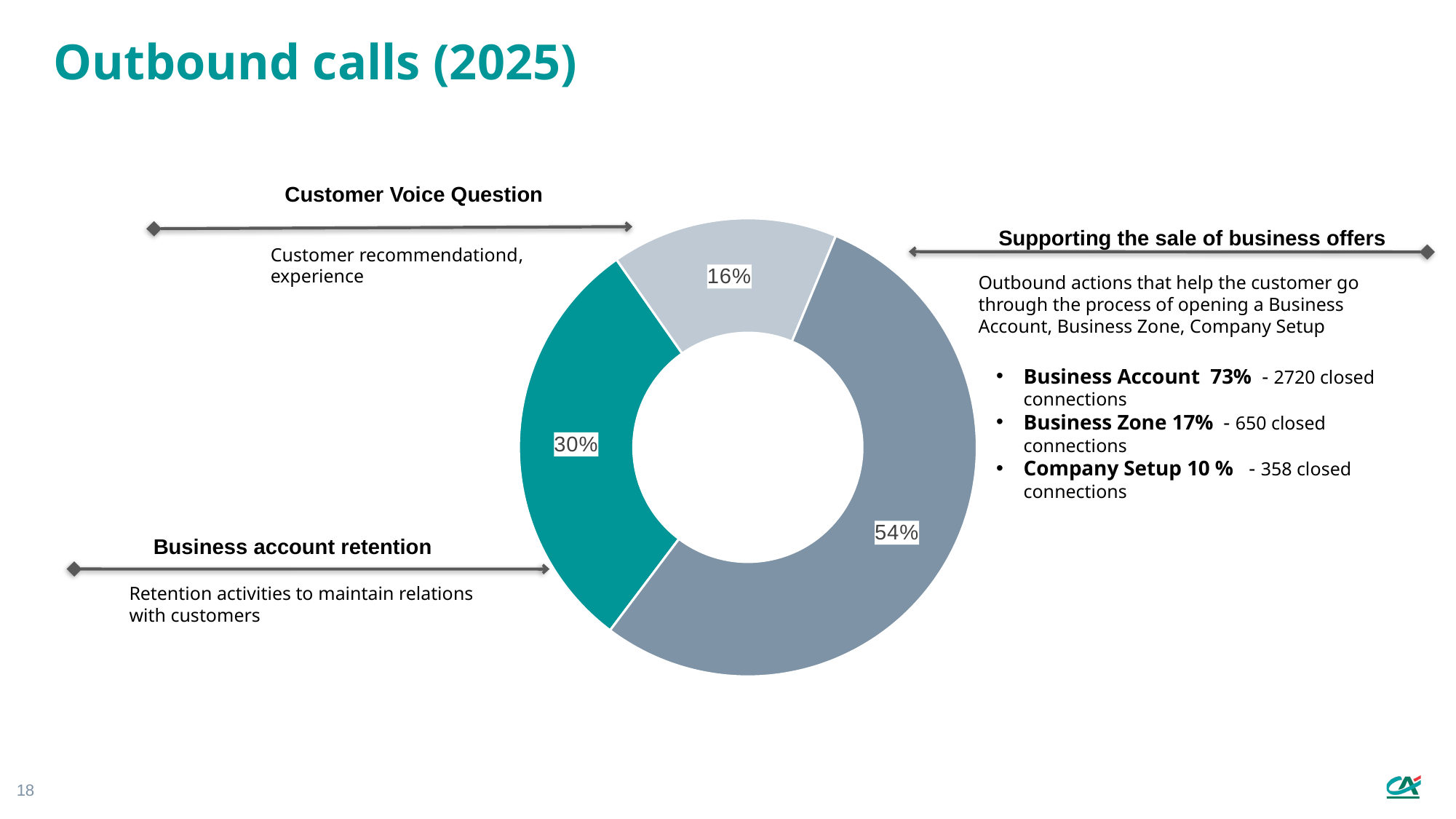
How many slices does the donut chart have? 3 What is the difference in percentage points between the Supporting the sale of business offers slice and the Business account retention slice? 24 percentage points What share of outbound calls is attributed to Supporting the sale of business offers? 54% Which category has the smallest share of the donut chart? Customer Voice Question What share of outbound calls is attributed to Customer Voice Question? 16% What kind of chart is shown on the slide? Pie chart (donut) Which category has the largest share of the donut chart? Supporting the sale of business offers What share of outbound calls is attributed to Business account retention? 30% Which is larger: the Business account retention slice or the Customer Voice Question slice? Business account retention What colour is the Business account retention slice? Teal What is the title of the slide containing the donut chart? Outbound calls (2025) What is the combined share of the Business account retention and Customer Voice Question slices? 46%